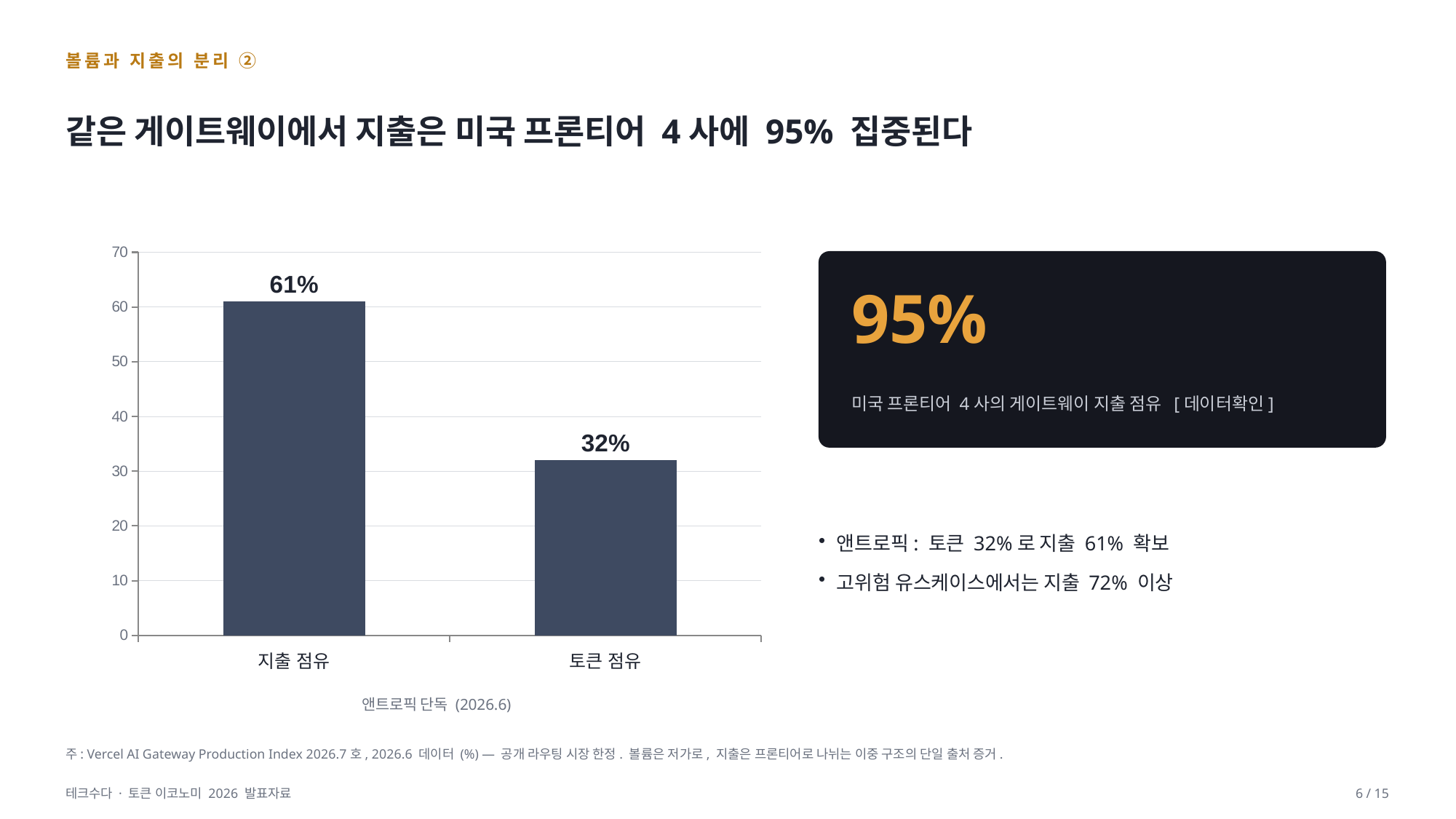
What kind of chart is shown on the slide? bar chart What is the highest value shown on the chart's y axis? 70 Which category has the highest value? 지출 점유 What is the difference between the values for 지출 점유 and 토큰 점유? 29% What is the value for 토큰 점유? 32% What is the caption shown below the chart's x axis? 앤트로픽 단독 (2026.6) Is the value for 토큰 점유 greater or less than 40? less What is the value for 지출 점유? 61% Which category has the lowest value? 토큰 점유 Is the value for 지출 점유 greater or less than 50? greater Which is larger, 지출 점유 or 토큰 점유? 지출 점유 How many categories are shown in the chart? 2